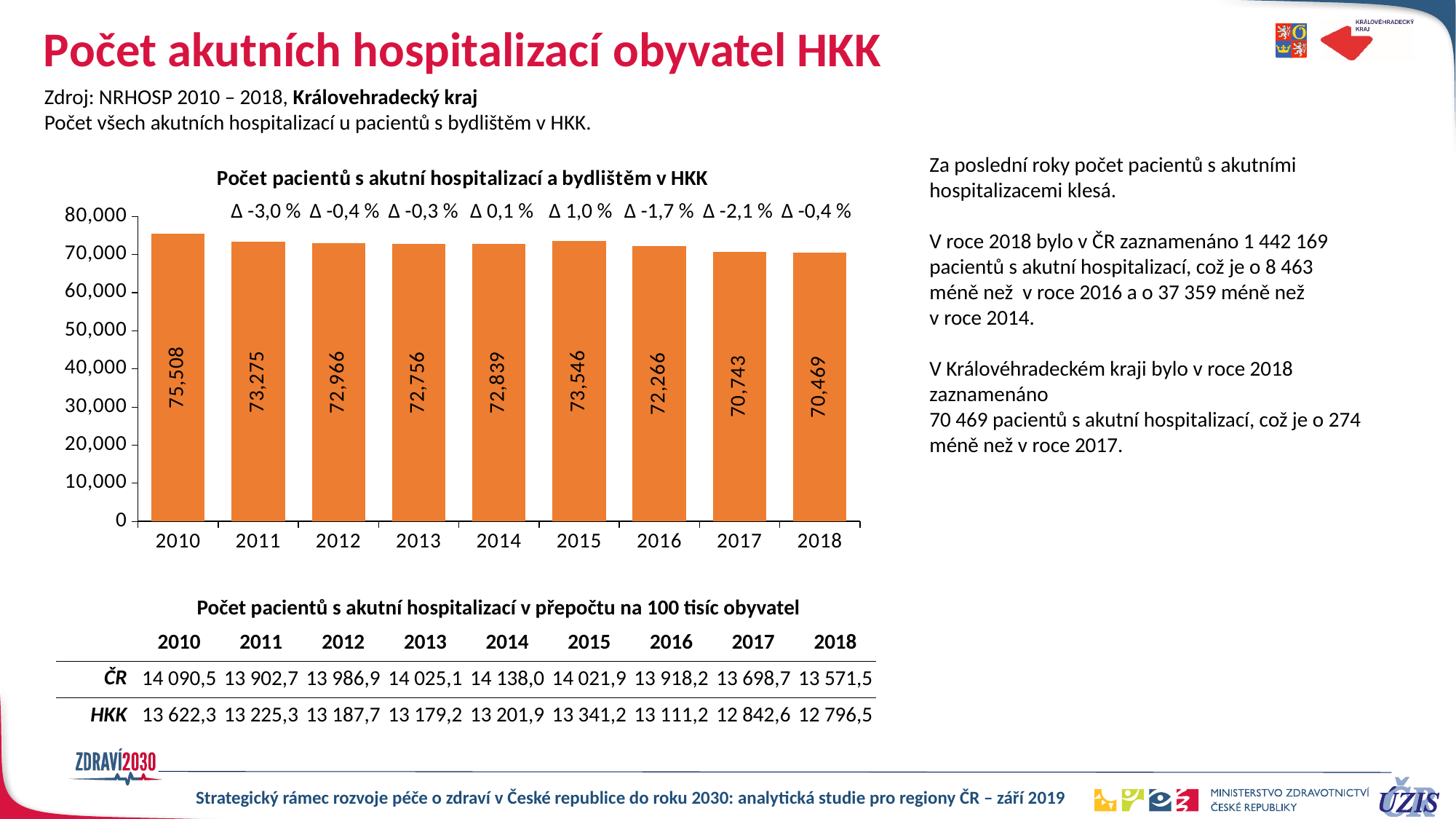
What is the difference between the values for 2017 and 2018? 274 What kind of chart is shown on the slide? bar chart What is the value for 2015 in the bar chart? 73,546 What is the difference between the values for 2010 and 2018? 5,039 Which year has the lowest value in the bar chart? 2018 What is the value for 2018 in the bar chart? 70,469 Is the value for 2018 greater or less than 80,000? less What is the value for 2010 in the bar chart? 75,508 Which is larger, the value for 2015 or the value for 2016? 2015 Which year has the highest value in the bar chart? 2010 What is the title of the bar chart? Počet pacientů s akutní hospitalizací a bydlištěm v HKK How many years are shown on the x axis of the bar chart? 9